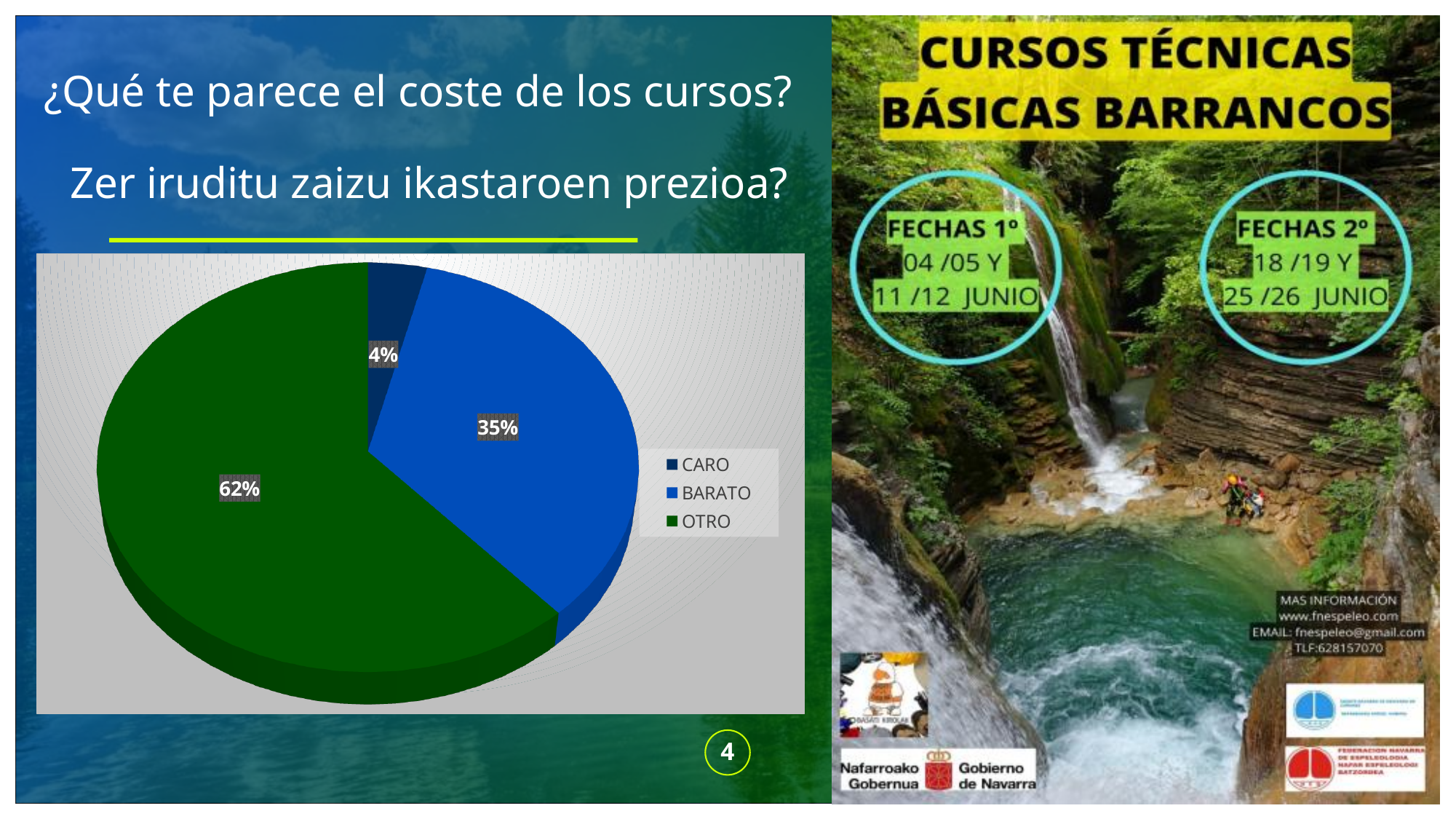
Which legend entry is shown in dark blue? CARO What percentage of the pie chart is labelled OTRO? 62% Which is larger, the BARATO slice or the CARO slice? BARATO What is the difference in percentage points between the BARATO and CARO slices? 31 What is the difference in percentage points between the OTRO and BARATO slices? 27 How many categories does the pie chart show? 3 What colour is the OTRO slice in the pie chart? green What percentage of the pie chart is labelled BARATO? 35% What kind of chart is shown on the slide? pie chart Which category has the largest share of the pie chart? OTRO Which category has the smallest share of the pie chart? CARO What percentage of the pie chart is labelled CARO? 4%